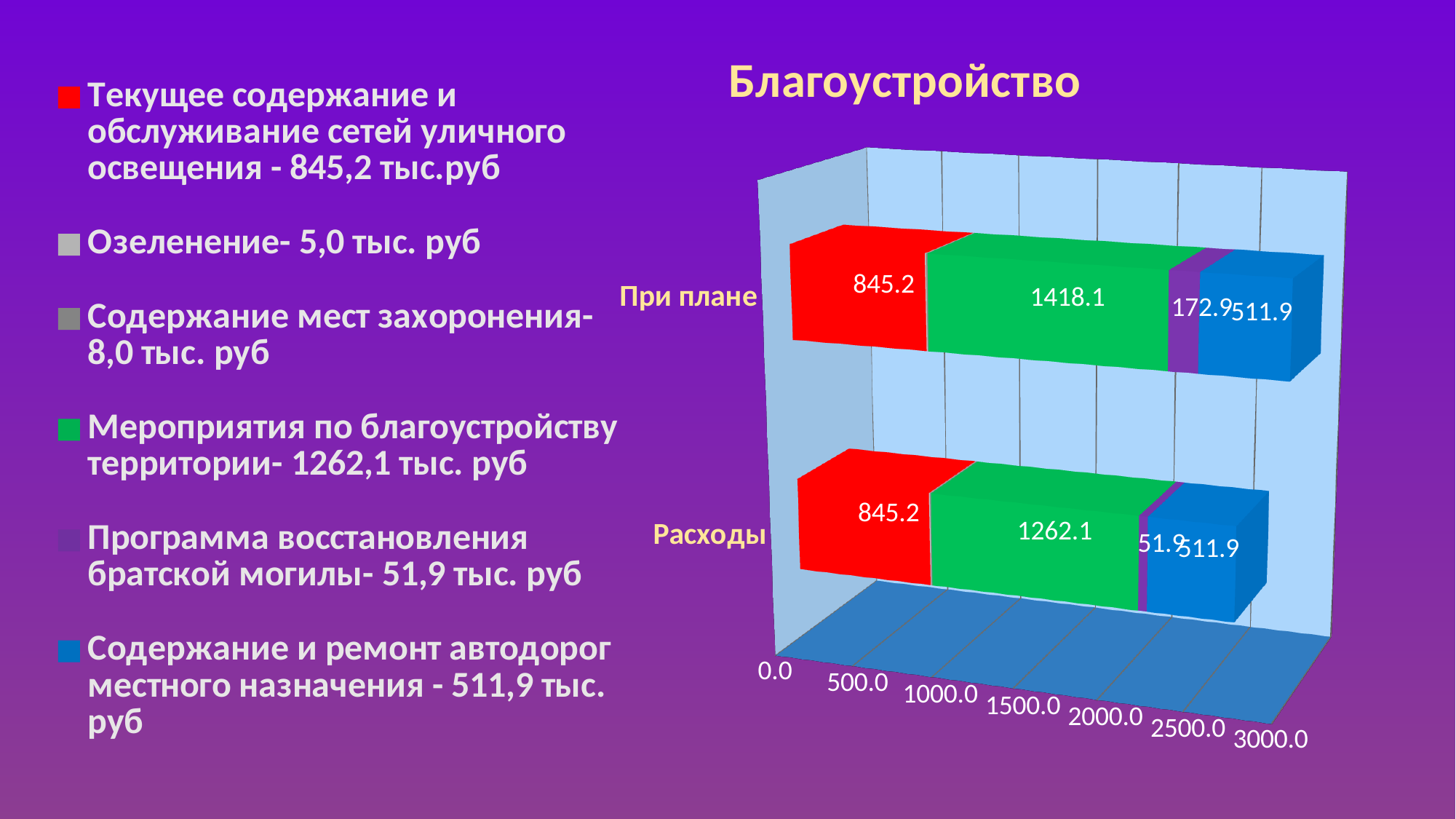
What is the value of the red segment (Текущее содержание и обслуживание сетей уличного освещения) for 'Расходы'? 845.2 What is the value of the green segment (Мероприятия по благоустройству территории) for 'При плане'? 1418.1 How many series does the legend list? 6 What is the value of the purple segment (Программа восстановления братской могилы) for 'При плане'? 172.9 What is the difference between the green segment values for 'При плане' and 'Расходы'? 156.0 What is the value of the green segment (Мероприятия по благоустройству территории) for 'Расходы'? 1262.1 What type of chart is shown on the slide? Stacked bar chart What is the title of the chart? Благоустройство Which category has the larger purple segment value, 'При плане' or 'Расходы'? При плане What is the value of the purple segment (Программа восстановления братской могилы) for 'Расходы'? 51.9 How many categories are plotted on the chart? 2 Which segment is the largest within the 'При плане' bar? Мероприятия по благоустройству территории (1418.1)